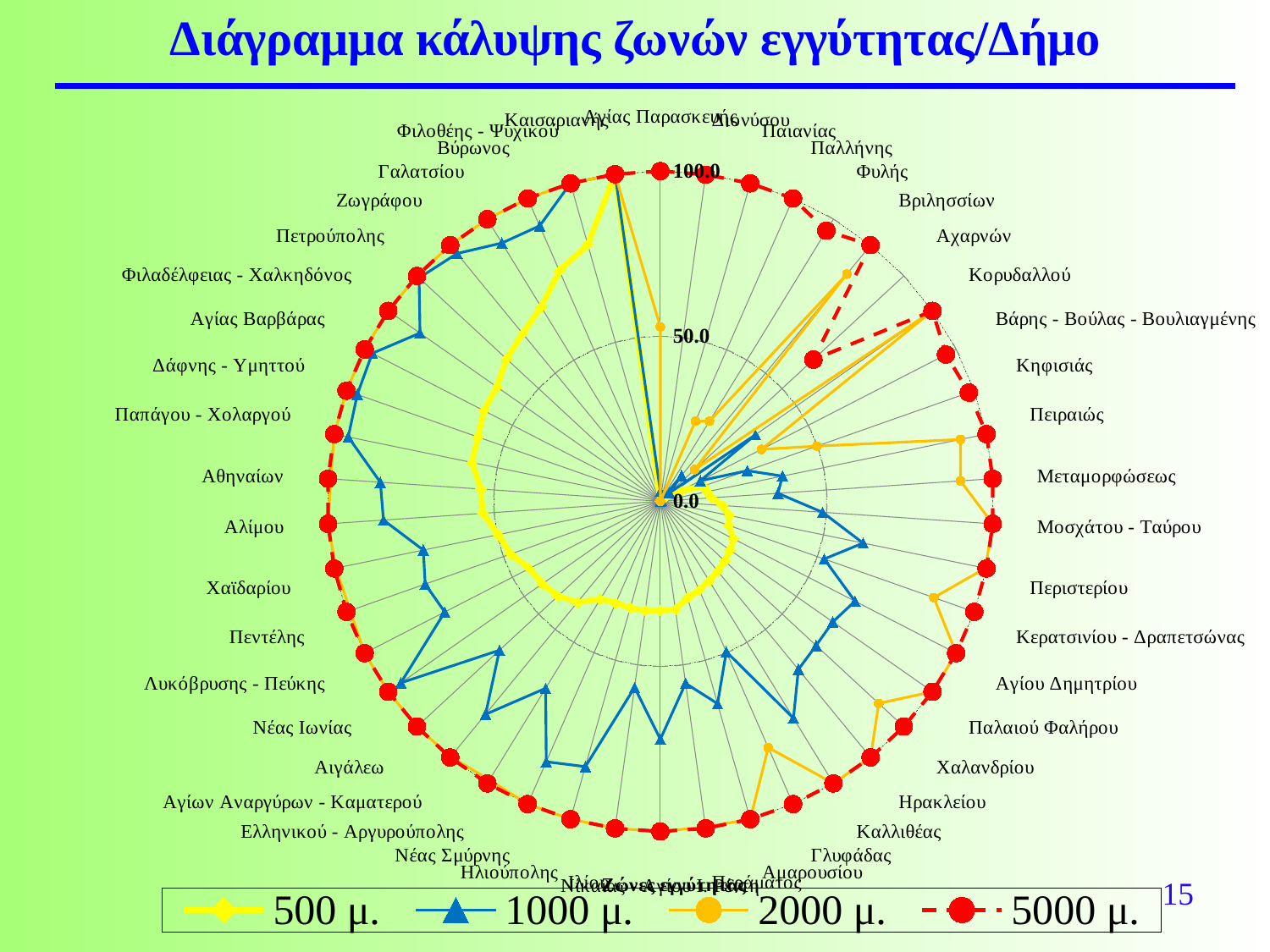
How many series does the legend list? 4 Is the value for Αθηναίων in the 5000 μ. series greater or less than 50? greater Which series is drawn with a red dashed line? 5000 μ. Is the value for Κηφισιάς in the 5000 μ. series greater or less than 50? greater Is the value for Αθηναίων in the 1000 μ. series greater or less than 50? greater For Αθηναίων, which series has the larger value: 500 μ. or 1000 μ.? 1000 μ. What is the title of the chart? Διάγραμμα κάλυψης ζωνών εγγύτητας/Δήμο What kind of chart is shown on the slide? Radar chart